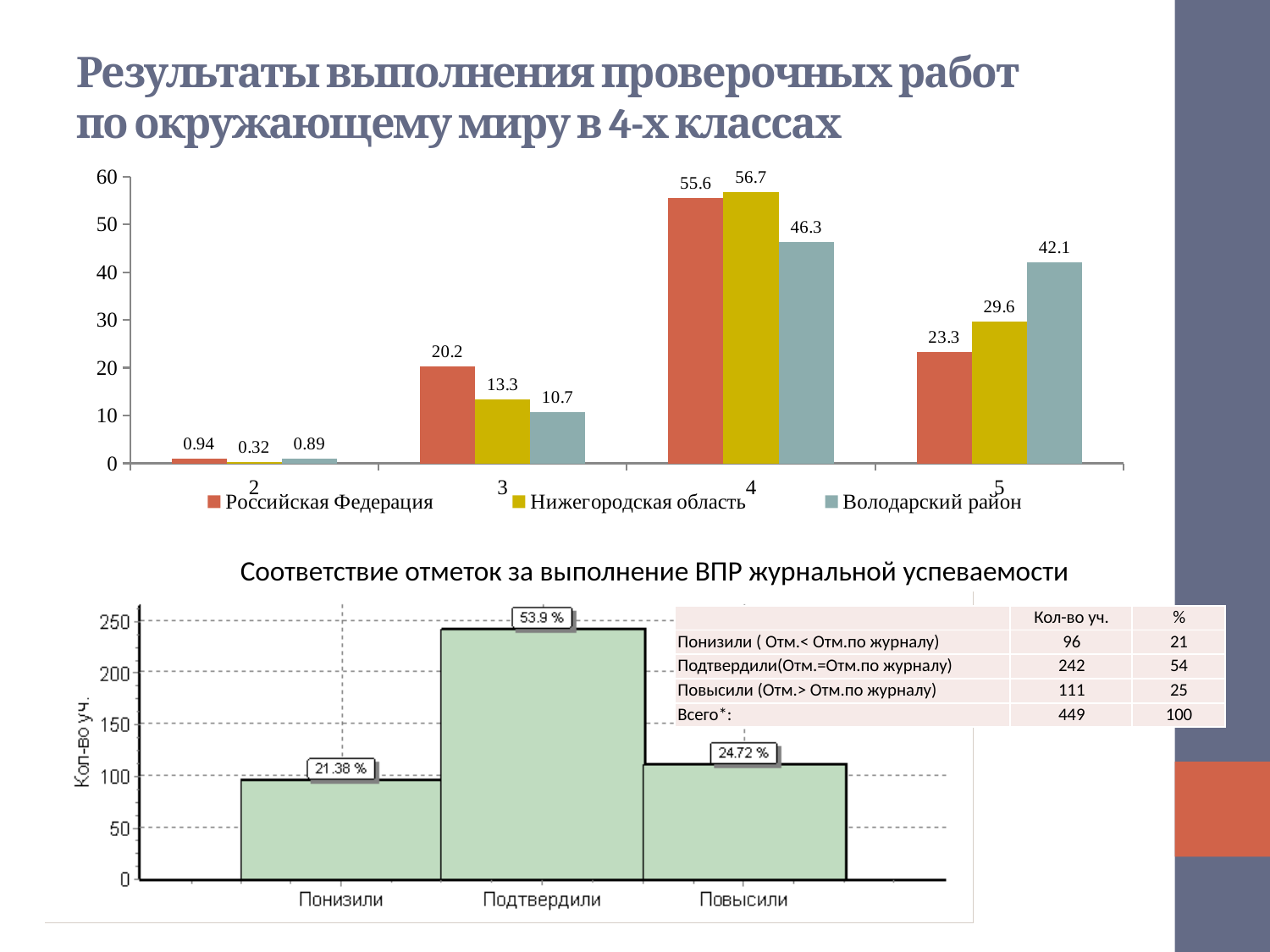
What kind of chart is the bottom chart? bar chart In the top chart, what is the difference between Володарский район and Российская Федерация for category 5? 18.8 In the top chart, which category has the highest value for Нижегородская область? 4 In the top chart, what is the value for Российская Федерация for category 3? 20.2 In the bottom chart, is the value for Повысили greater or less than 100? greater In the top chart, for category 3, which is larger: Российская Федерация or Володарский район? Российская Федерация In the top chart, what is the value for Нижегородская область for category 2? 0.32 How many categories are shown on the x axis of the top chart? 4 How many series does the legend of the top chart list? 3 In the top chart, what is the value for Володарский район for category 4? 46.3 In the top chart, which category has the lowest value for Володарский район? 2 In the bottom chart (Соответствие отметок за выполнение ВПР журнальной успеваемости), what percentage label is shown for Подтвердили? 53.9 %